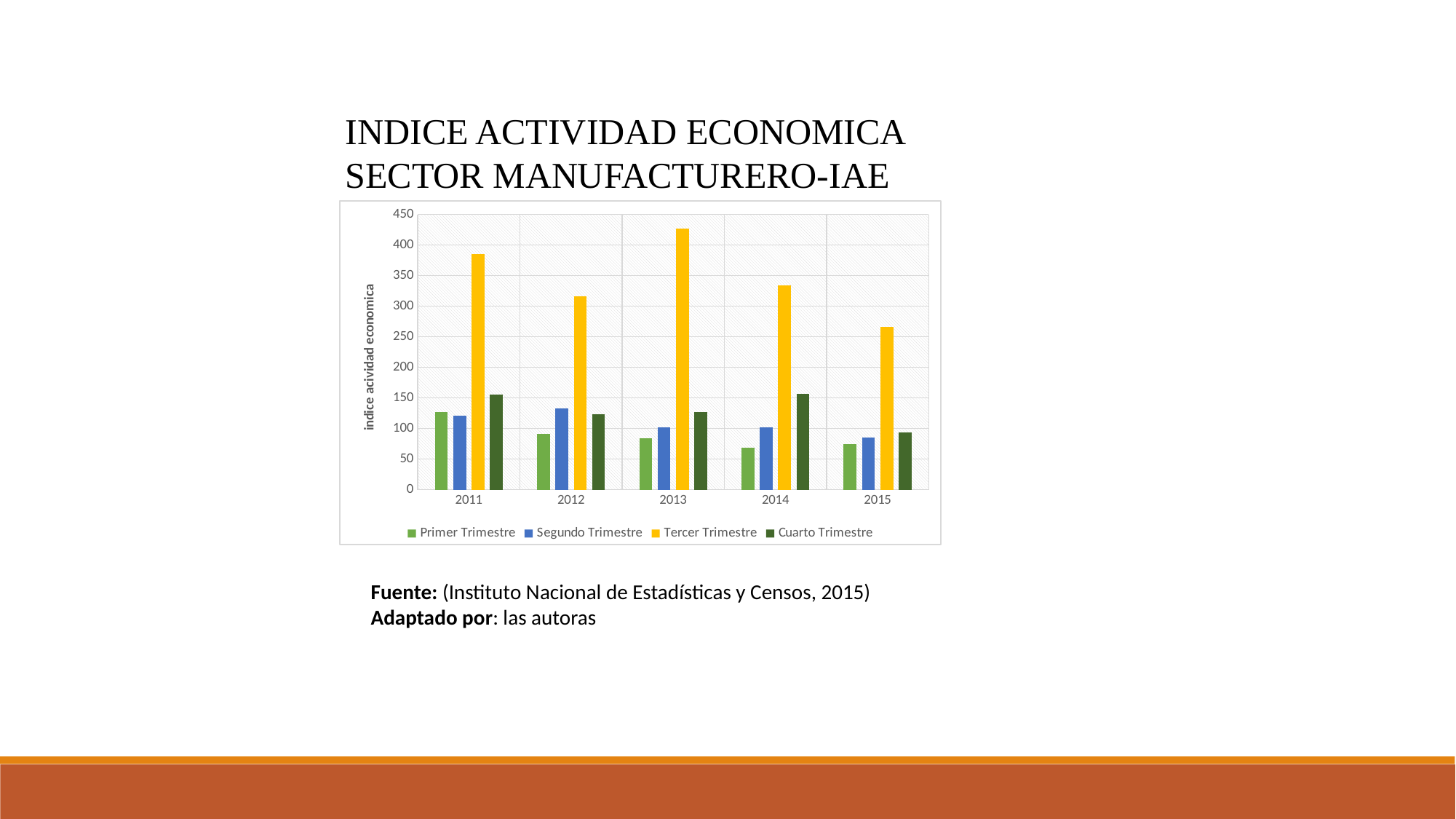
Which series has the highest bar in every year? Tercer Trimestre Is the value for Tercer Trimestre in 2013 greater or less than 400? greater How many years are shown on the x axis? 5 Is the value for Primer Trimestre in 2011 greater or less than 100? greater What kind of chart is shown on the slide? bar chart Which is larger, the Tercer Trimestre value in 2011 or in 2012? 2011 In which year is the Tercer Trimestre bar the lowest? 2015 In which year is the Tercer Trimestre bar the highest? 2013 Which is larger in 2014, the Primer Trimestre value or the Cuarto Trimestre value? Cuarto Trimestre How many series does the legend list? 4 Is the value for Tercer Trimestre in 2015 greater or less than 300? less What is the label on the vertical axis? indice acividad economica